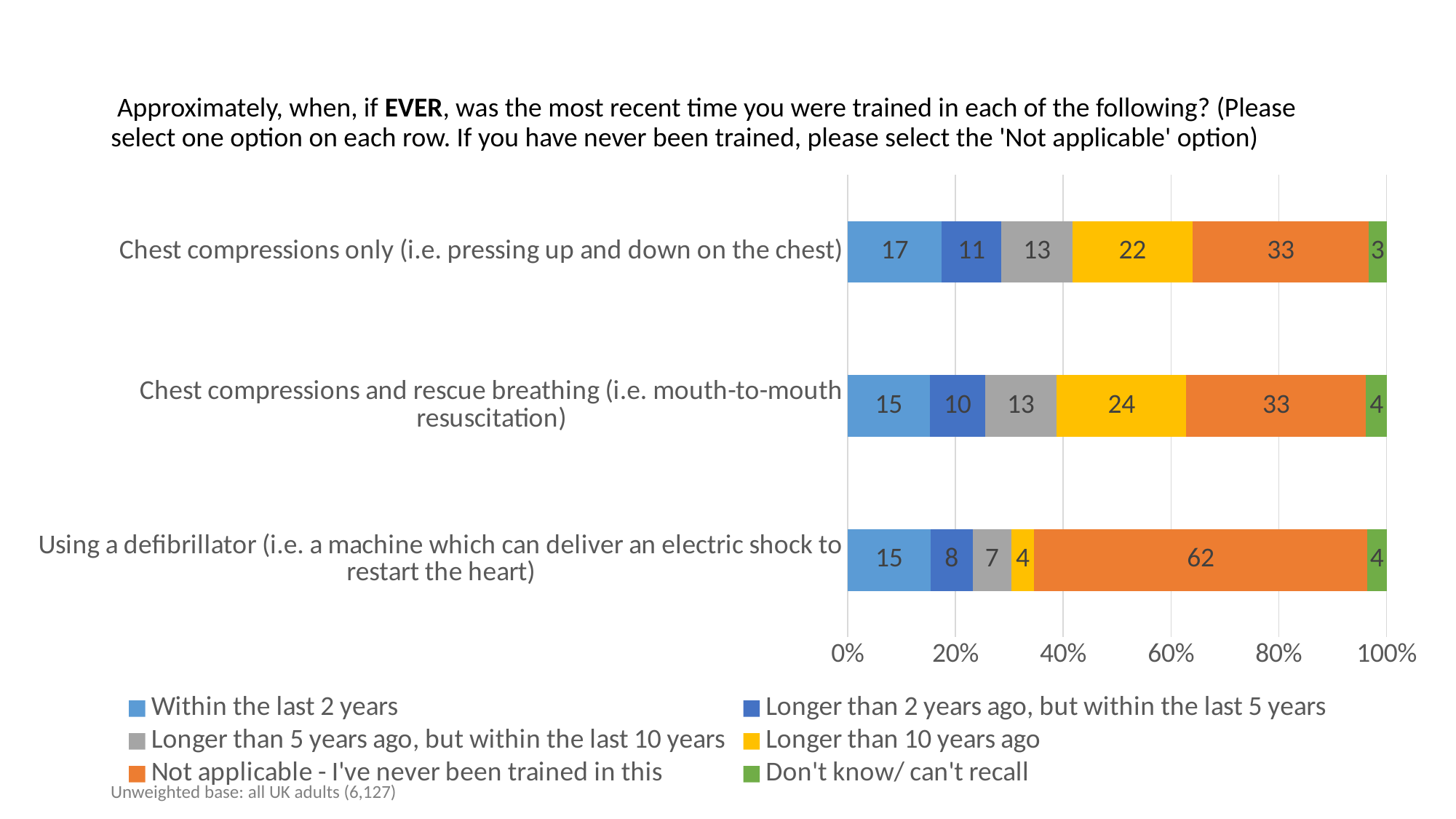
How many series does the legend list? 6 Which category has the lowest value for 'Longer than 10 years ago'? Using a defibrillator What is the total of the 'Within the last 2 years' and 'Longer than 2 years ago, but within the last 5 years' values for 'Chest compressions only'? 28 Which is larger: the 'Longer than 2 years ago, but within the last 5 years' value for 'Chest compressions only' or for 'Using a defibrillator'? Chest compressions only Which colour represents 'Don't know/ can't recall' in the legend? Green What is the value for 'Within the last 2 years' for 'Chest compressions only'? 17 What is the value for 'Not applicable - I've never been trained in this' for 'Using a defibrillator'? 62 Which category has the highest value for 'Not applicable - I've never been trained in this'? Using a defibrillator What is the difference between the 'Longer than 10 years ago' values for 'Chest compressions and rescue breathing' and 'Chest compressions only'? 2 How many categories are shown on the chart? 3 What kind of chart is shown on the slide? Stacked bar chart What is the value for 'Longer than 10 years ago' for 'Chest compressions and rescue breathing'? 24